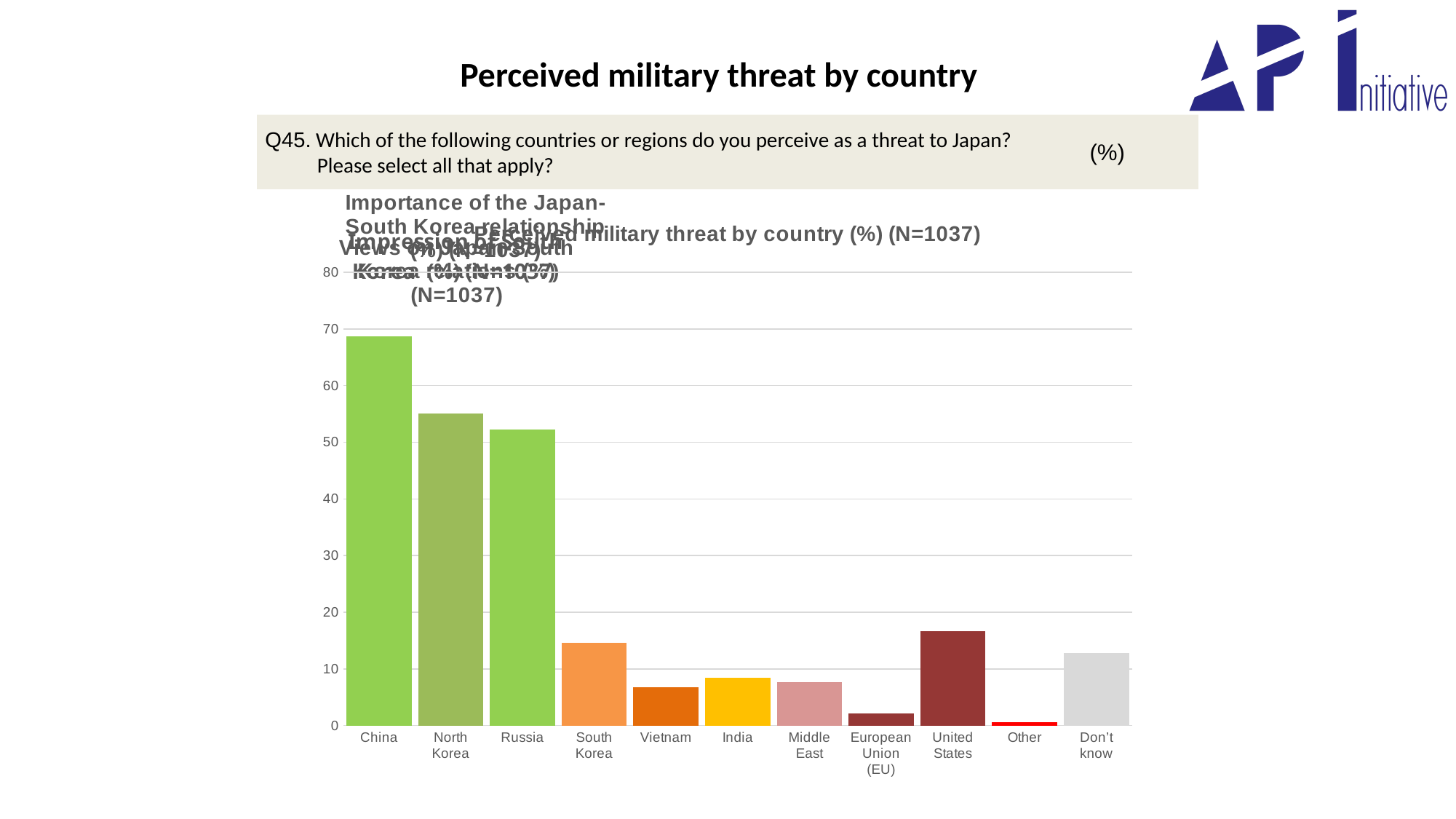
What kind of chart is shown on the slide? bar chart What is the title of the slide? Perceived military threat by country How many categories are shown along the x axis of the chart? 11 Is the value for the European Union (EU) greater or less than 10? less Is the value for China greater or less than 60? greater Which category has the lowest bar in the chart? Other Is the value for North Korea greater or less than 50? greater Which has a larger value, the United States or South Korea? United States Which country or region has the highest bar in the chart? China Which has a larger value, China or North Korea? China